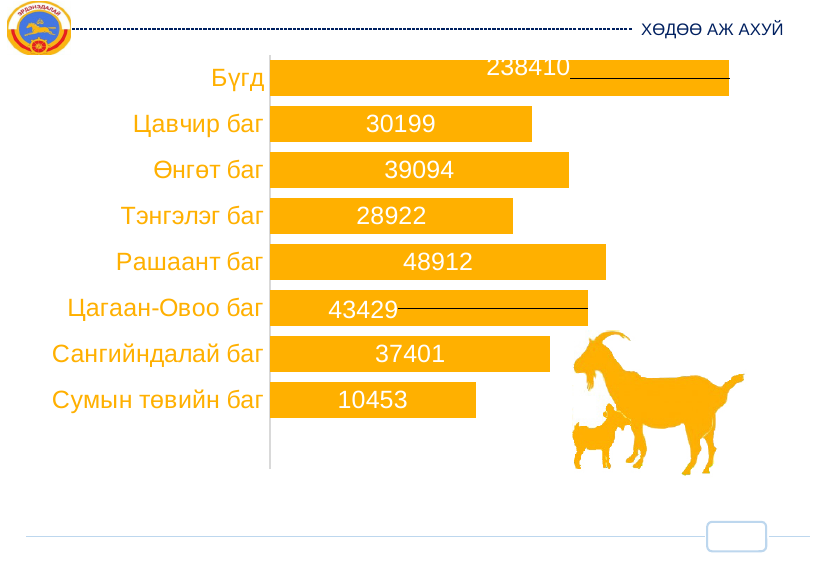
What is the value for Рашаант баг? 48912 What is the value for Сумын төвийн баг? 10453 Which баг has the lowest value? Сумын төвийн баг What is the value shown for Бүгд? 238410 What kind of chart is shown on the slide? Bar chart How many categories (bars) are shown in the chart? 8 What is the value for Цагаан-Овоо баг? 43429 What is the difference between the values for Рашаант баг and Цагаан-Овоо баг? 5483 Excluding the Бүгд total, which баг has the highest value? Рашаант баг Which is larger, the value for Сангийндалай баг or Тэнгэлэг баг? Сангийндалай баг What colour are the bars in the chart? Orange What is the difference between the values for Өнгөт баг and Цавчир баг? 8895